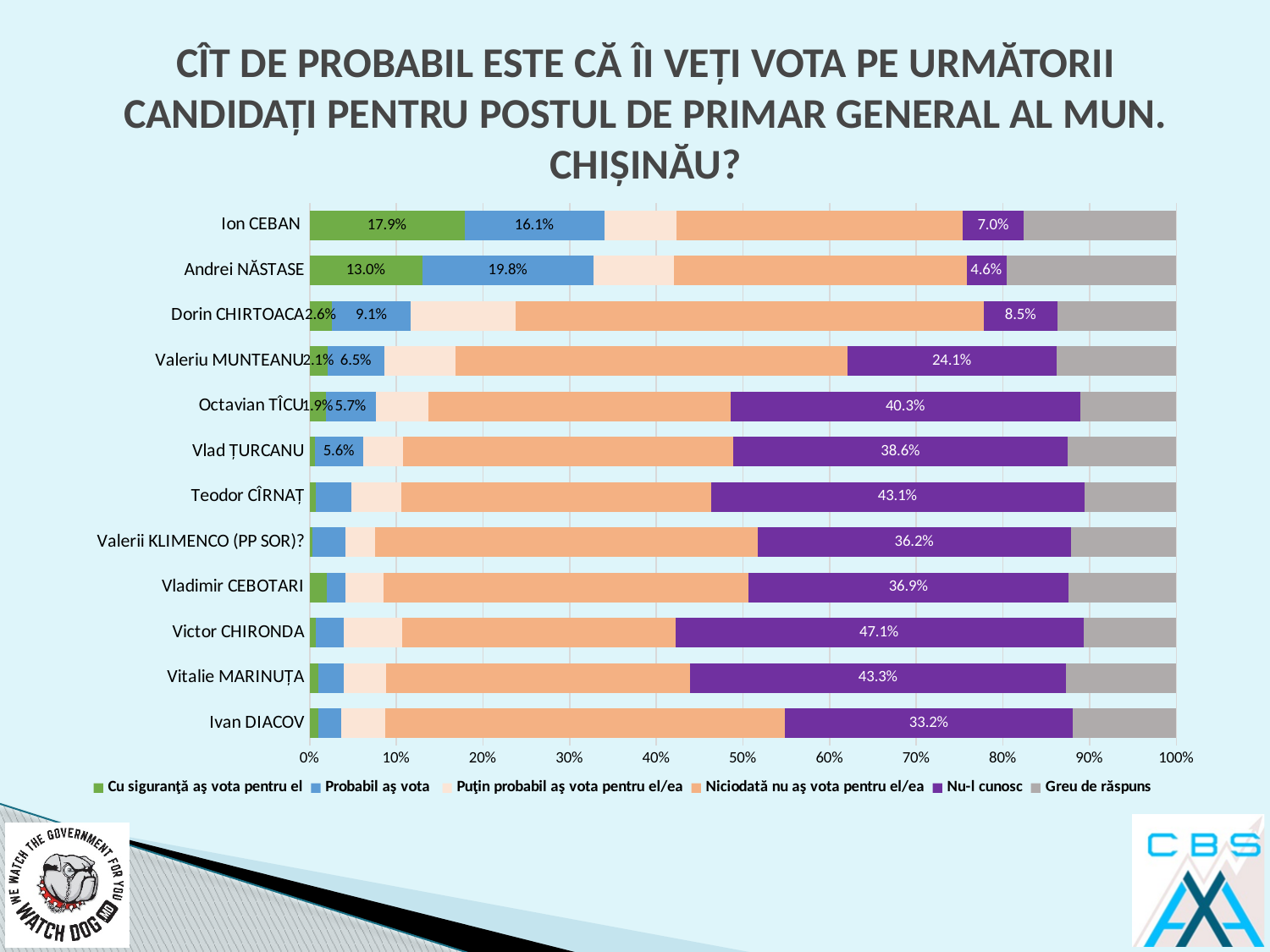
Which colour represents 'Nu-l cunosc' in the legend? purple What is the 'Cu siguranță aș vota pentru el' value for Ion CEBAN? 17.9% What is the difference between the 'Cu siguranță aș vota pentru el' values for Ion CEBAN and Andrei NĂSTASE? 4.9% Which candidate has the lowest 'Nu-l cunosc' value? Andrei NĂSTASE What is the 'Nu-l cunosc' value for Ivan DIACOV? 33.2% Which is larger: the 'Nu-l cunosc' value for Octavian TÎCU or for Vlad ȚURCANU? Octavian TÎCU Which candidate has the highest 'Nu-l cunosc' value? Victor CHIRONDA How many candidates are listed on the chart? 12 What type of chart is shown on the slide? stacked bar chart What is the 'Nu-l cunosc' value for Victor CHIRONDA? 47.1% How many series does the legend list? 6 What is the 'Probabil aș vota' value for Andrei NĂSTASE? 19.8%